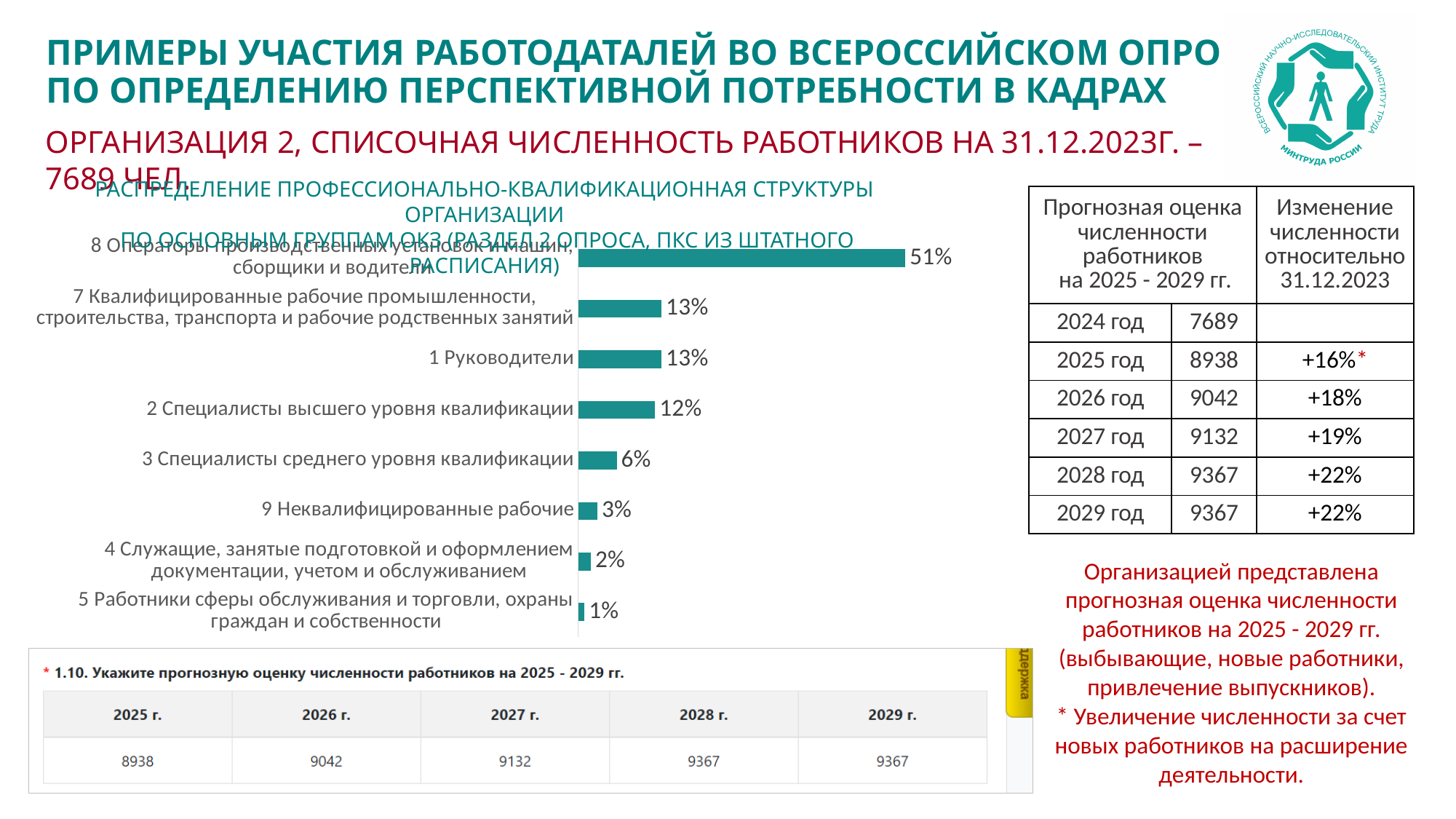
What is the difference between the values for "2 Специалисты высшего уровня квалификации" and "3 Специалисты среднего уровня квалификации"? 6% Which is larger: the value for "9 Неквалифицированные рабочие" or the value for "4 Служащие, занятые подготовкой и оформлением документации, учетом и обслуживанием"? 9 Неквалифицированные рабочие What is the value for "5 Работники сферы обслуживания и торговли, охраны граждан и собственности" in the bar chart? 1% What colour are the bars in the chart? teal What is the highest value shown in the bar chart? 51% What is the value for "3 Специалисты среднего уровня квалификации" in the bar chart? 6% What kind of chart is shown on the slide? bar chart What is the value for "9 Неквалифицированные рабочие" in the bar chart? 3% How many categories does the bar chart show? 8 What is the value for "2 Специалисты высшего уровня квалификации" in the bar chart? 12% Which category has the lowest value in the bar chart? 5 Работники сферы обслуживания и торговли, охраны граждан и собственности What is the value for "1 Руководители" in the bar chart? 13%